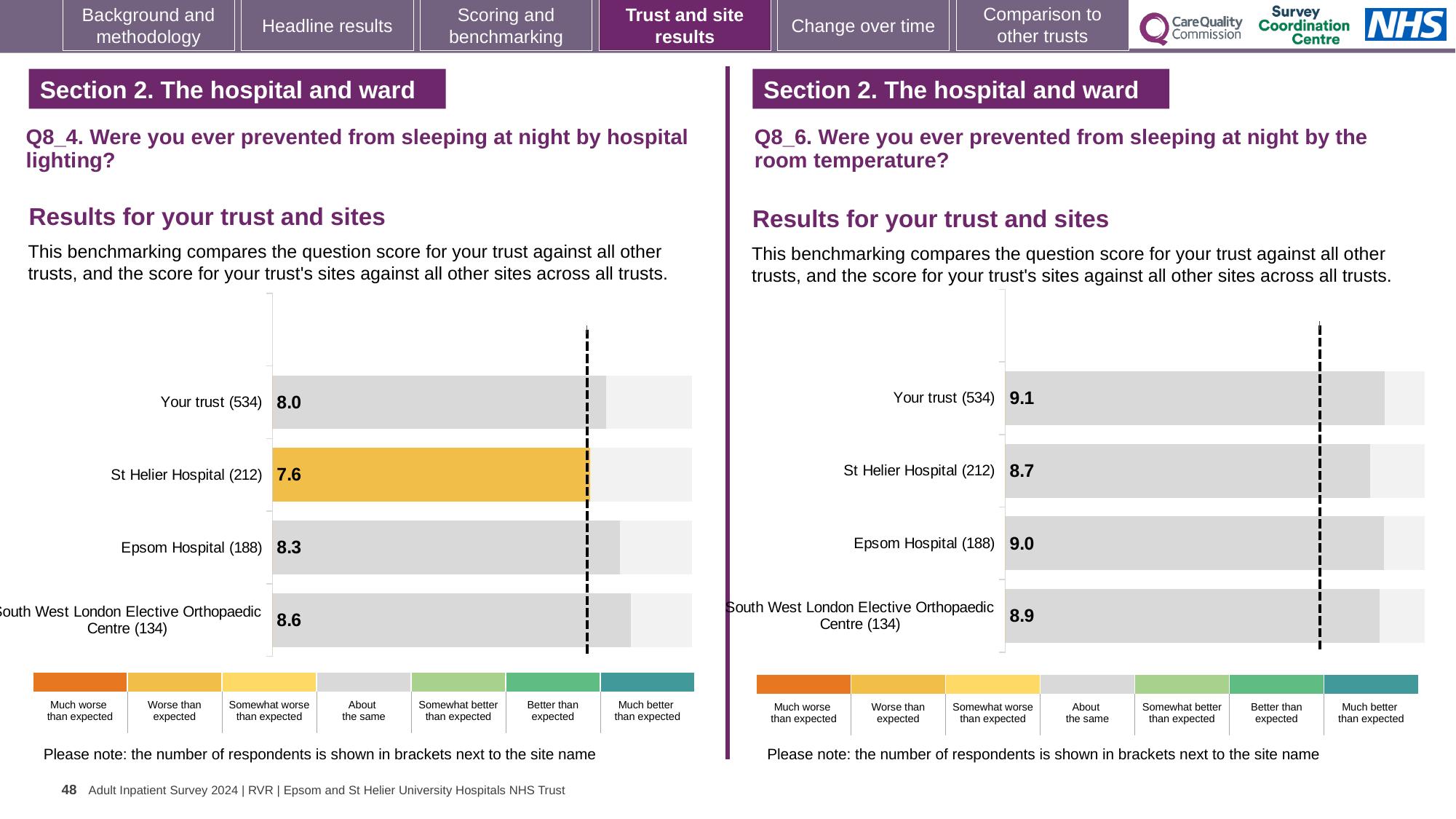
In the Q8_6 room temperature chart, which row has the highest score? Your trust (534) What type of chart is used for the Q8_6 room temperature results? Bar chart In the Q8_6 room temperature chart, is the score for Your trust (534) or St Helier Hospital (212) larger? Your trust (534) In the Q8_6 room temperature chart, what is the score for Epsom Hospital (188)? 9.0 In the Q8_4 hospital lighting chart, what is the score for St Helier Hospital (212)? 7.6 In the Q8_6 room temperature chart, which site has the lowest score? St Helier Hospital (212) In the Q8_4 hospital lighting chart, which site has the lowest score? St Helier Hospital (212) In the Q8_4 hospital lighting chart, which site has the highest score? South West London Elective Orthopaedic Centre (134) In the Q8_4 hospital lighting chart, what is the score for Your trust (534)? 8.0 In the Q8_4 hospital lighting chart, what is the difference between the scores for Epsom Hospital (188) and St Helier Hospital (212)? 0.7 In the Q8_6 room temperature chart, what is the score for South West London Elective Orthopaedic Centre (134)? 8.9 How many rows (trust and sites) are plotted in the Q8_4 hospital lighting chart? 4